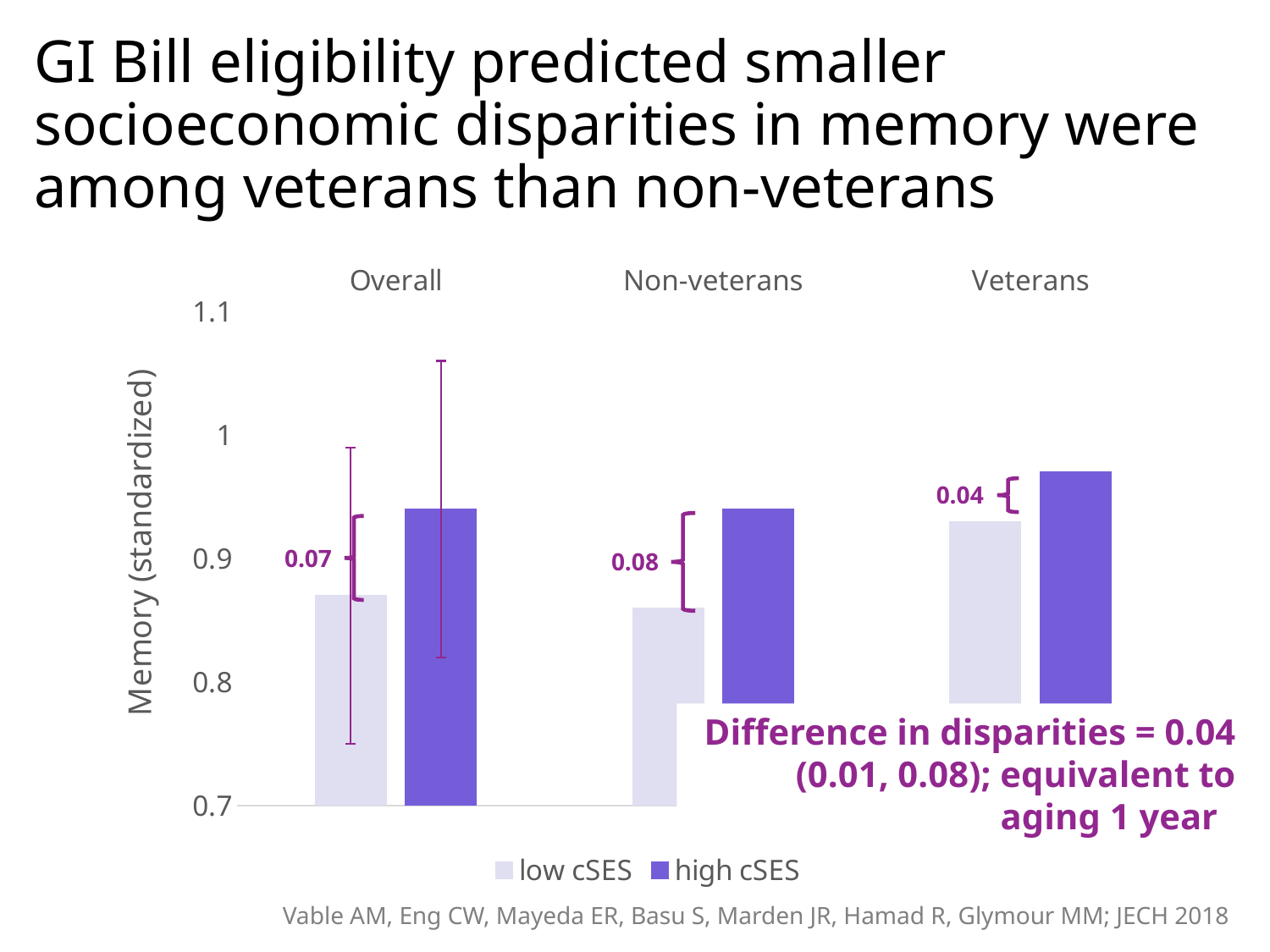
What are the two series named in the legend? low cSES and high cSES Which group has the largest annotated disparity between low and high cSES? Non-veterans Is the low cSES value for Non-veterans greater or less than 0.9? less What kind of chart is shown on the slide? bar chart What disparity value is annotated for the Non-veterans group? 0.08 What is the label on the y axis? Memory (standardized) How many groups of bars are shown along the x axis? 3 What disparity value is annotated between the low and high cSES bars for the Overall group? 0.07 How many series does the legend list? 2 Which group has the smallest annotated disparity between low and high cSES? Veterans What disparity value is annotated for the Veterans group? 0.04 Is the high cSES value for Veterans greater or less than 1? less